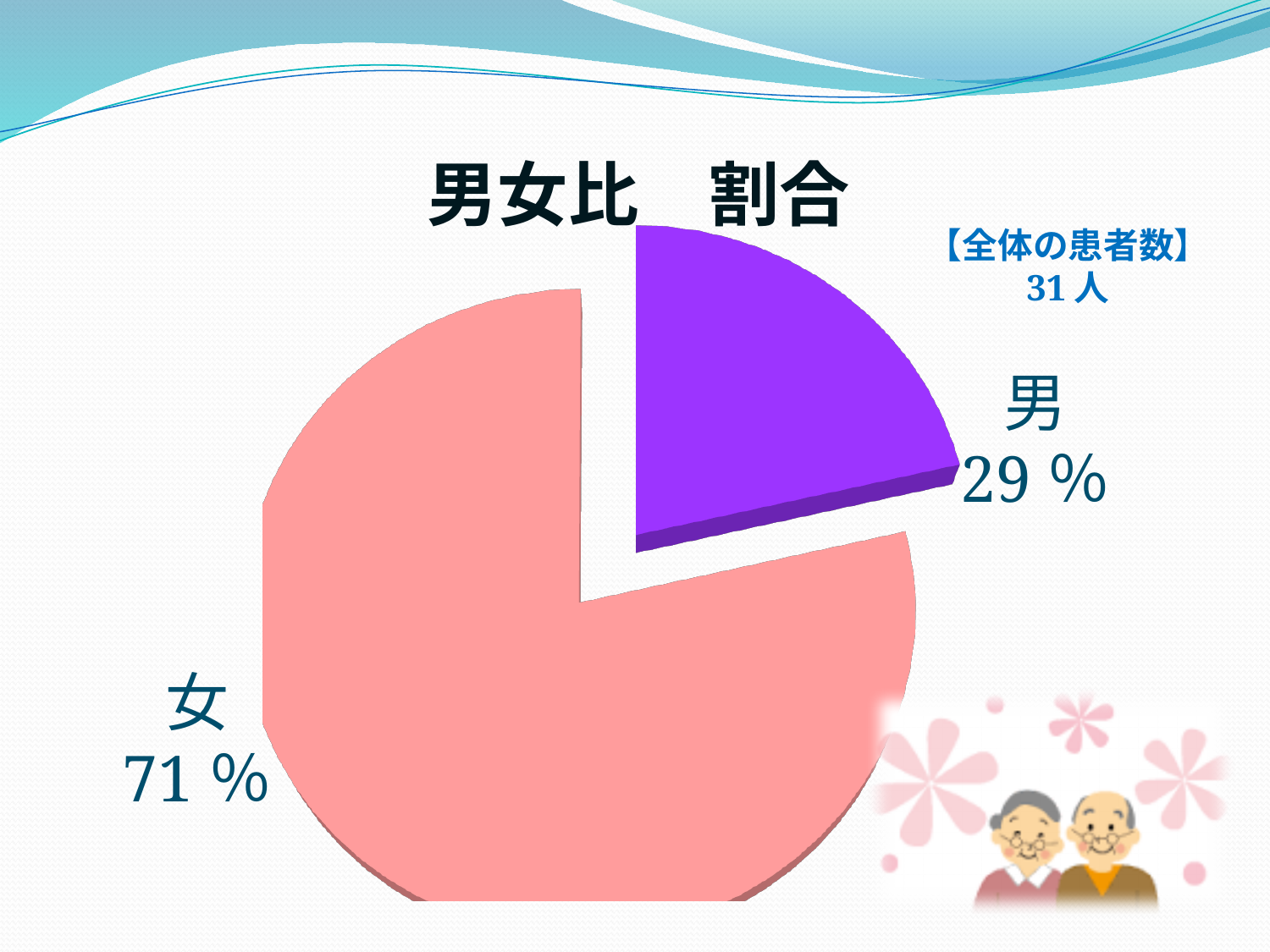
Which is larger, the share for 男 or the share for 女? 女 What colour is the 男 slice? purple What is the chart's title? 男女比 割合 What kind of chart is shown on the slide? pie chart Which slice is the smallest? 男 Which slice is the largest? 女 What is the total number of patients stated on the slide (全体の患者数)? 31 人 What share of the pie does the 男 slice represent? 29 % What percentage is shown for 女 (female)? 71 % What percentage is shown for 男 (male)? 29 % How many slices does the pie chart have? 2 What is the difference in percentage points between 女 and 男? 42